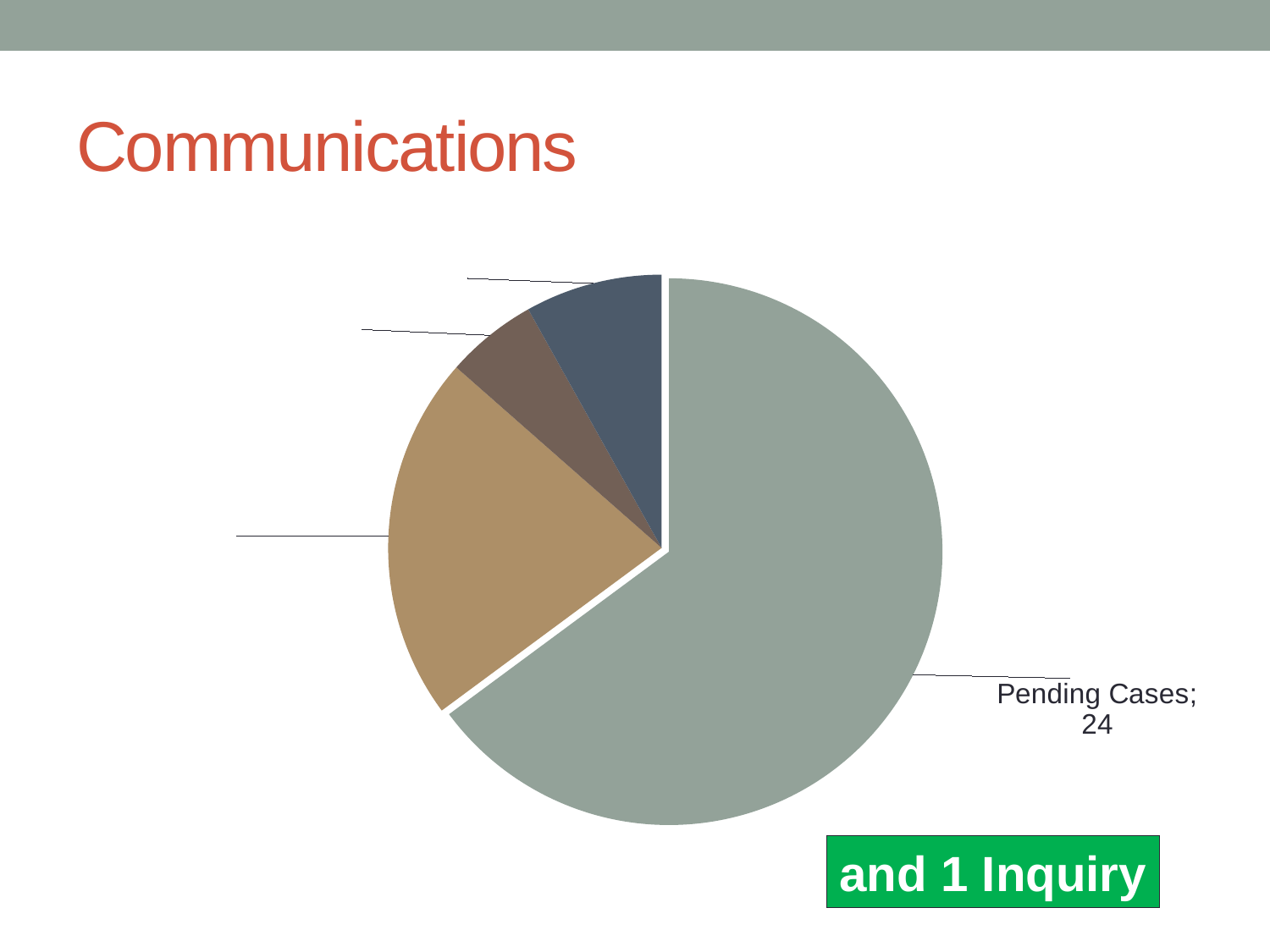
Is the Pending Cases slice larger or smaller than the tan-coloured slice? larger How many slices does the pie chart have? 4 What is the title text at the top of the slide above the pie chart? Communications What kind of chart is shown on the slide? pie chart What is the value shown for Pending Cases in the pie chart? 24 Which slice of the pie chart is the largest? Pending Cases Which slice of the pie chart is pulled out (exploded) from the rest? Pending Cases